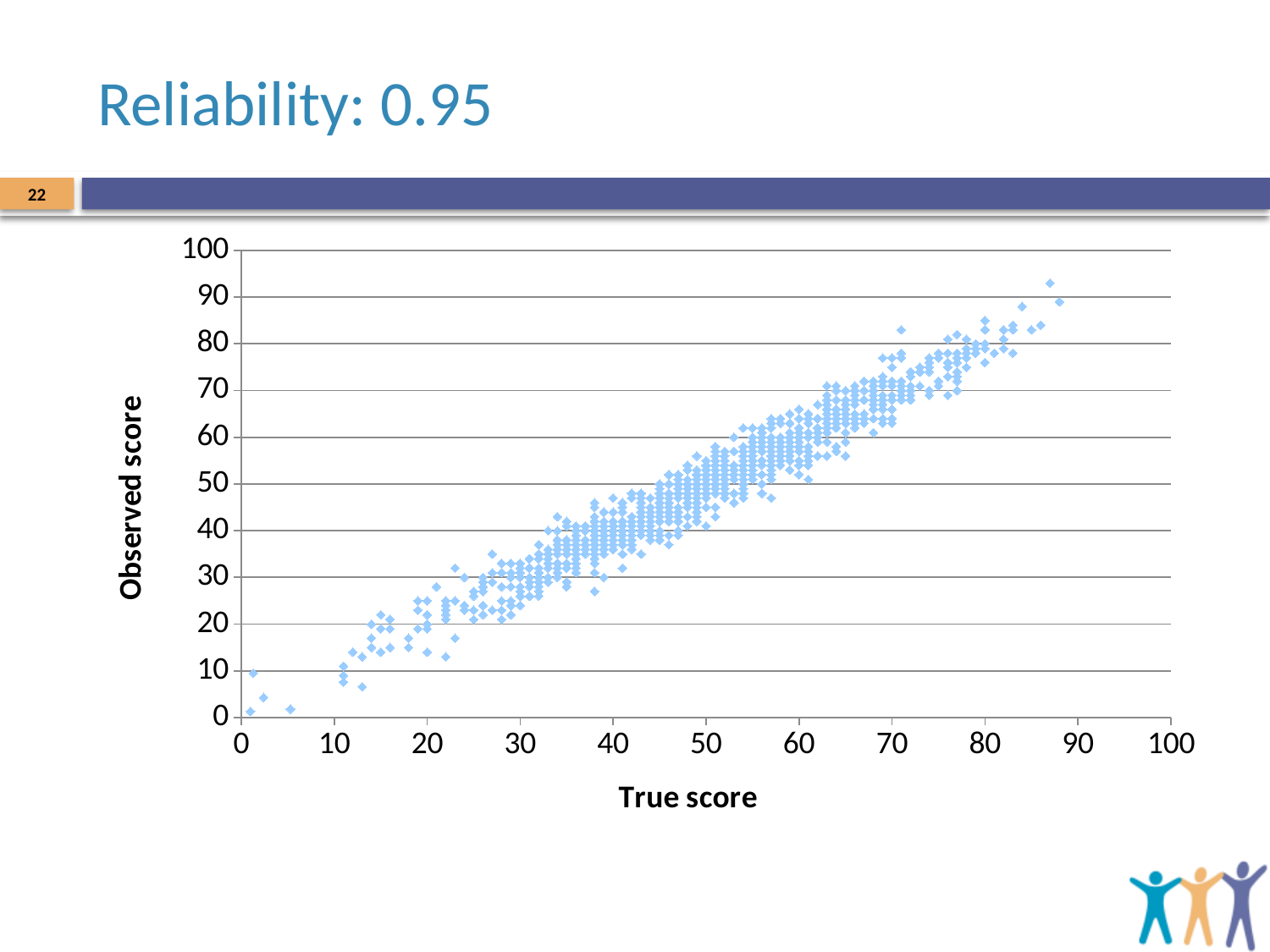
Is the lowest observed score plotted greater or less than 10? less What is the title of the y axis? Observed score What is the title of the x axis? True score What kind of chart is shown on the slide? scatter plot Is the highest observed score plotted greater or less than 80? greater Do the observed scores rise or fall as the true score increases along the x axis? rise Is the observed score for the point with the largest true score greater or less than 80? greater